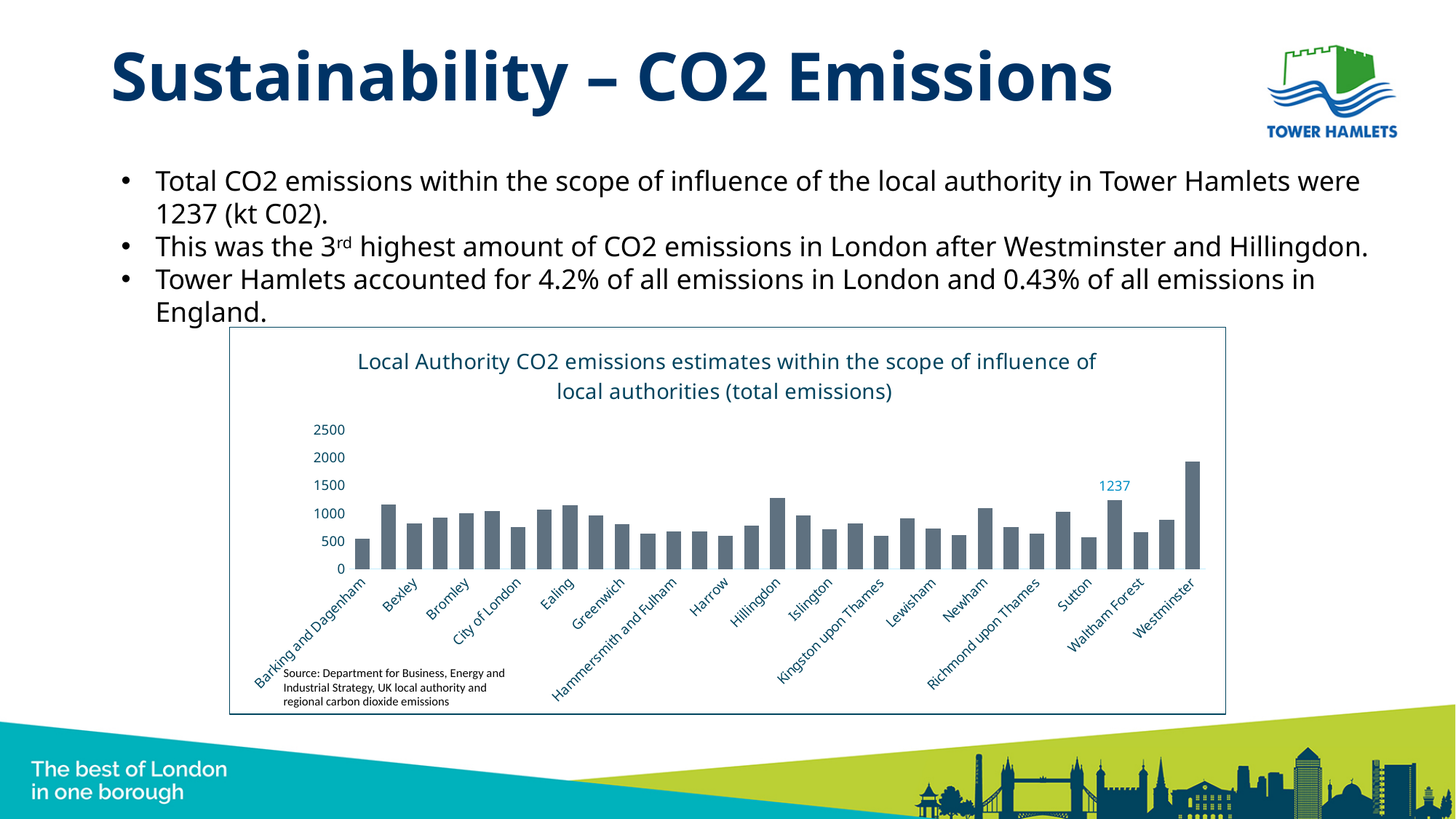
Which has higher CO2 emissions, Westminster or Hillingdon? Westminster Is the value for Harrow greater or less than 1000? less Is the value for Barking and Dagenham greater or less than 1000? less What type of chart is shown on the slide? bar chart Is the value for Hillingdon greater or less than 1000? greater What is the title of the chart? Local Authority CO2 emissions estimates within the scope of influence of local authorities (total emissions) Which has higher CO2 emissions, Hillingdon or Harrow? Hillingdon Which local authority has the highest CO2 emissions in the chart? Westminster What is the highest value shown on the vertical axis of the chart? 2500 Which has higher CO2 emissions, Ealing or Greenwich? Ealing What value is printed as a data label on the chart? 1237